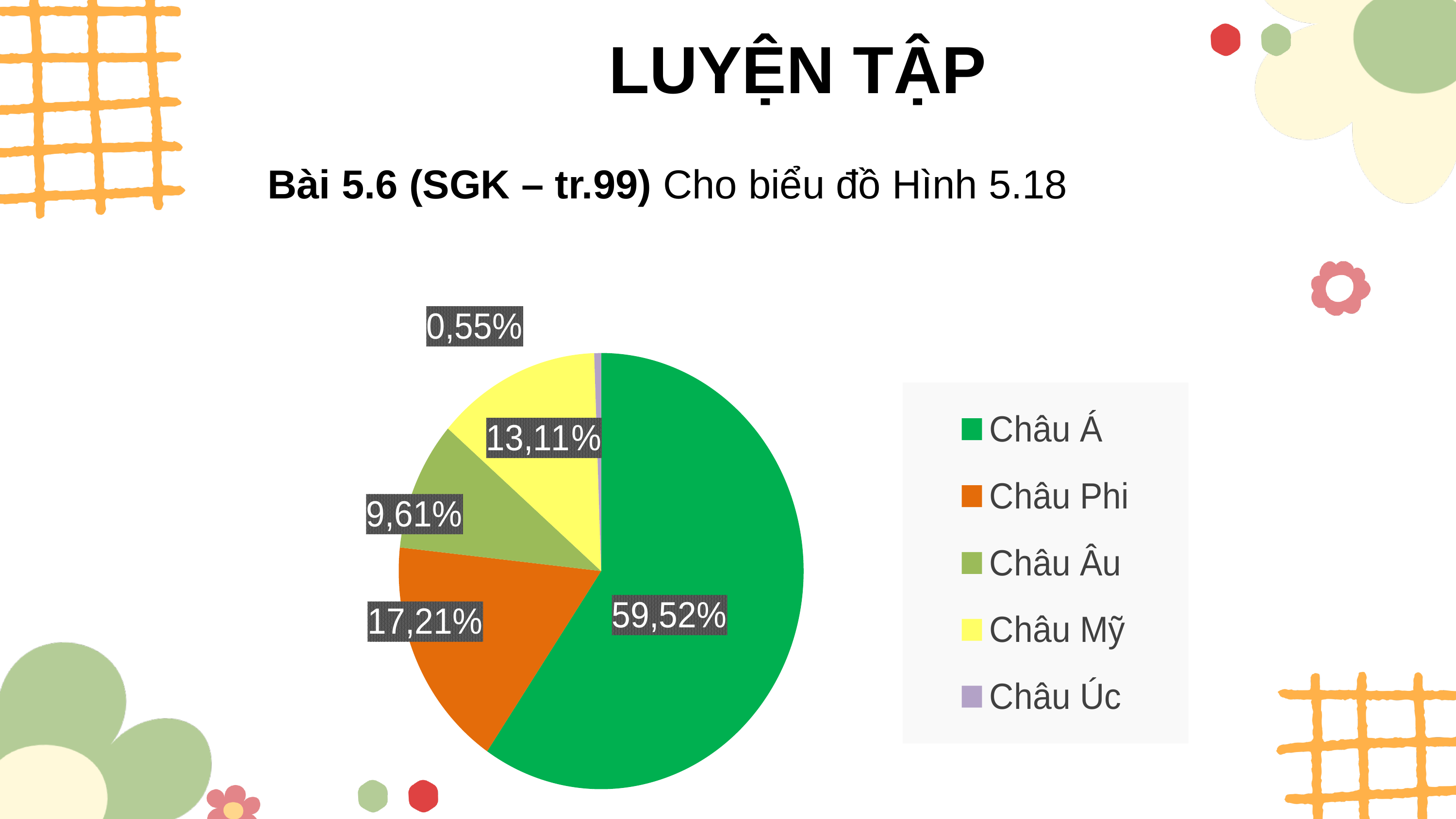
How many slices does the pie chart have? 5 What kind of chart is shown on the slide? pie chart Which is larger, the share for Châu Phi or the share for Châu Mỹ? Châu Phi What is the difference between the share for Châu Á and the share for Châu Phi? 42,31% Which category has the smallest slice of the pie? Châu Úc What share of the pie does Châu Úc have? 0,55% What share of the pie does Châu Mỹ have? 13,11% What share of the pie does Châu Phi have? 17,21% Which colour represents Châu Mỹ in the pie chart? yellow Which category has the largest slice of the pie? Châu Á